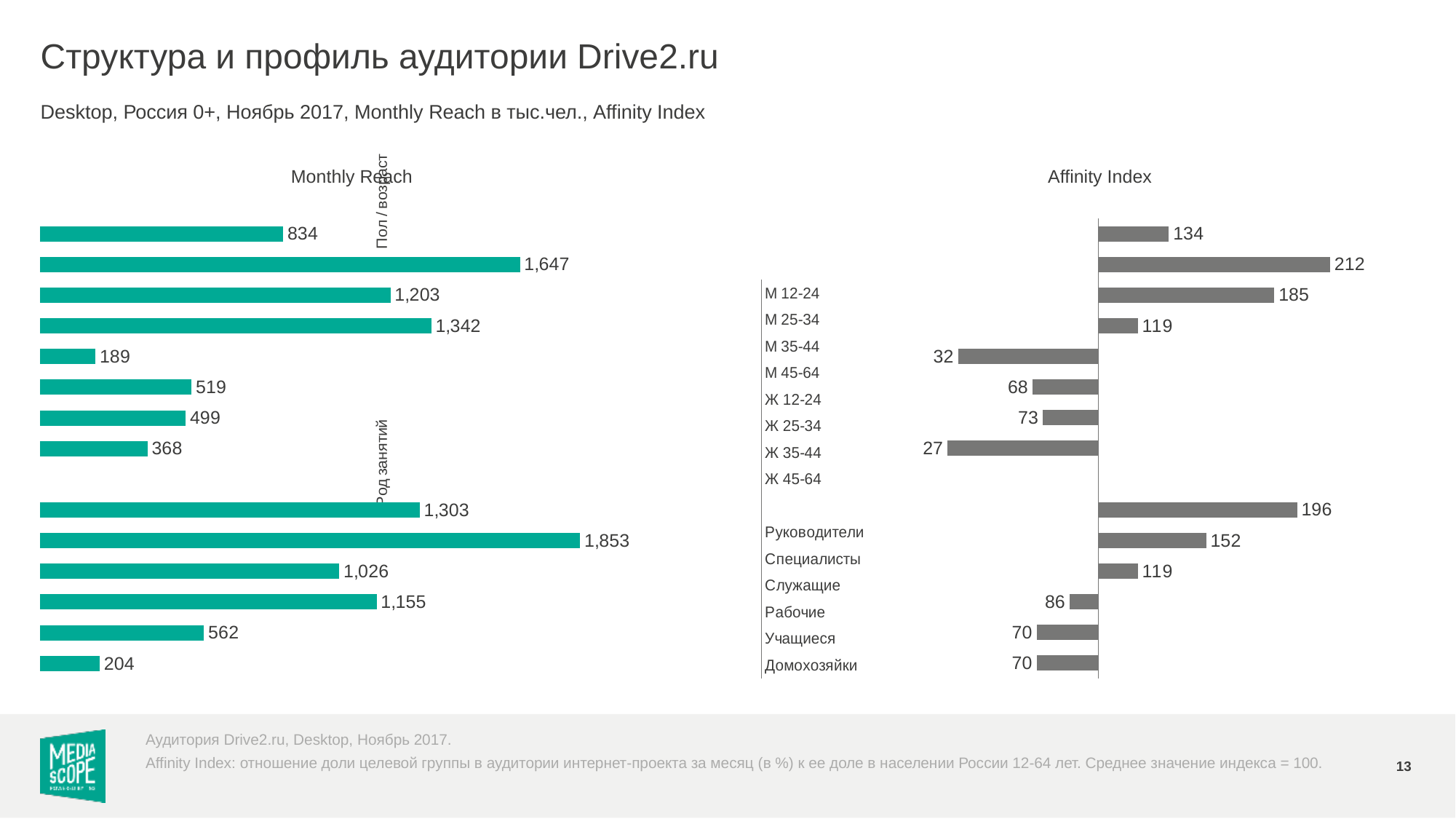
In the Affinity Index chart, which category has the highest value? М 25-34 In the Monthly Reach chart, which category has the lowest value? Ж 12-24 How many categories are plotted in the Affinity Index chart? 14 In the Affinity Index chart, which is larger, the value for Специалисты or the value for Служащие? Специалисты In the Monthly Reach chart, what is the value for М 25-34? 1,647 In the Monthly Reach chart, what is the difference between the values for М 25-34 and М 12-24? 813 In the Monthly Reach chart, what is the value for Специалисты? 1,853 In the Affinity Index chart, what is the value for Ж 45-64? 27 What kind of chart is the Monthly Reach chart? bar chart In the Affinity Index chart, what is the difference between the values for Руководители and Рабочие? 110 In the Affinity Index chart, what is the value for Руководители? 196 What is the title of the chart on the right side of the slide? Affinity Index